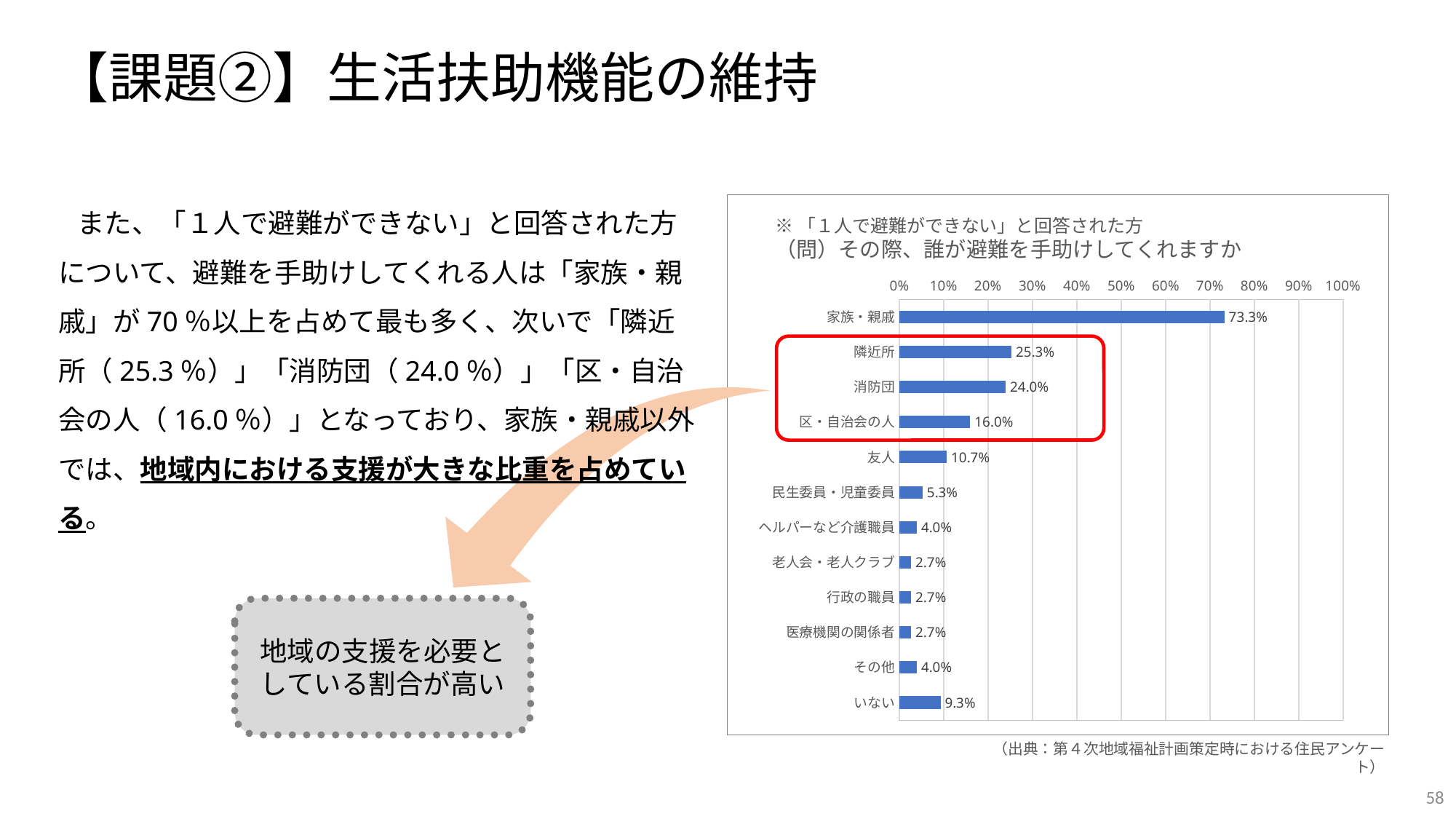
What is the value for 区・自治会の人? 16.0% Which categories are enclosed by the red outline on the chart? 隣近所, 消防団, 区・自治会の人 What is the difference between the values for 区・自治会の人 and 友人? 5.3 percentage points Which category has the highest value? 家族・親戚 What is the value for 消防団? 24.0% Is the value for 家族・親戚 greater or less than 70%? greater How many categories are shown in the chart? 12 What is the value for いない? 9.3% Which is larger, the value for 隣近所 or the value for 友人? 隣近所 What is the value for 家族・親戚? 73.3% What is the difference between the values for 家族・親戚 and 隣近所? 48.0 percentage points What kind of chart is shown on the slide? bar chart